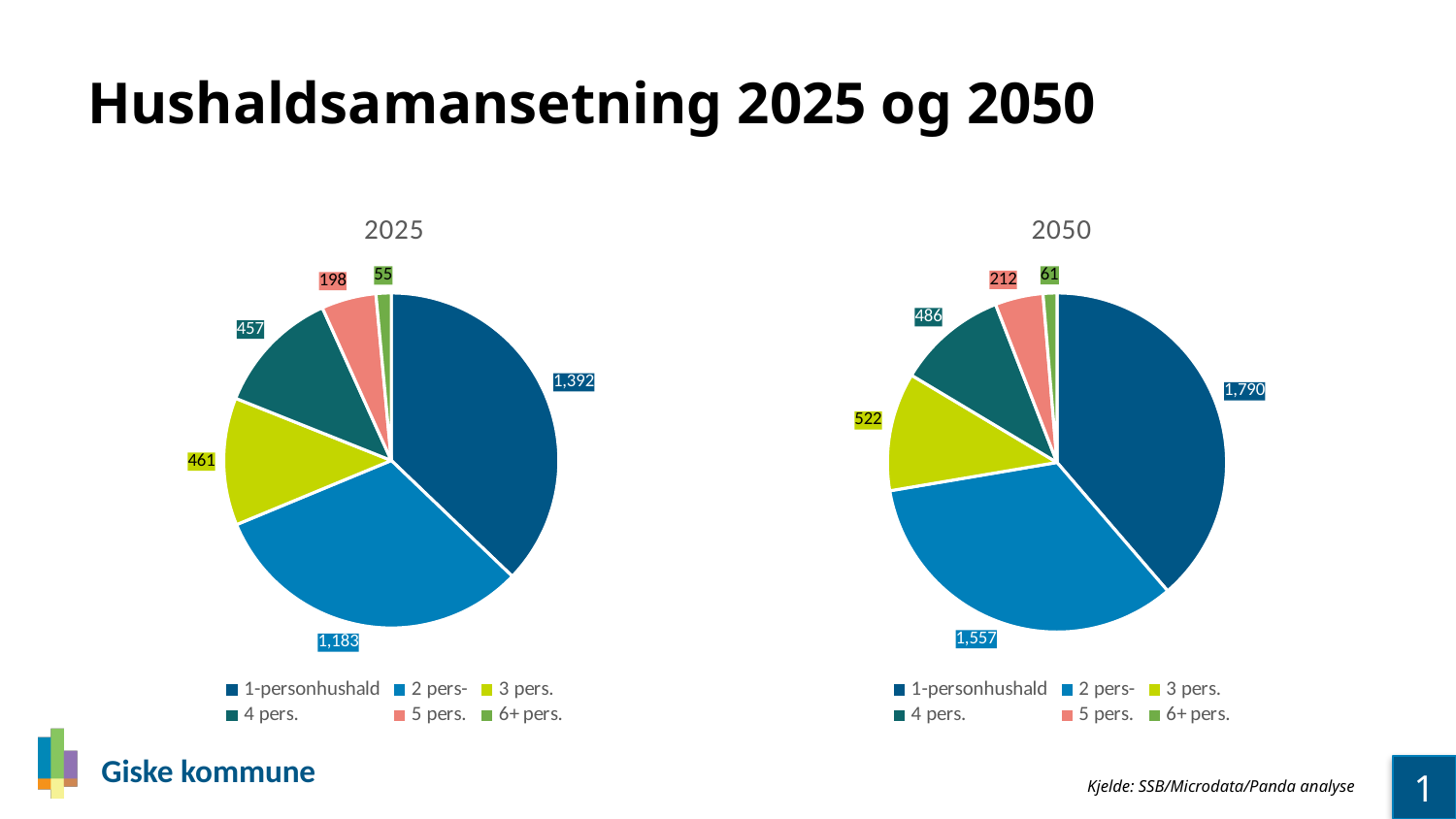
In the 2025 pie chart, what is the value for 1-personhushald? 1,392 In the 2050 pie chart, what is the value for 2 pers-? 1,557 In the 2050 pie chart, which category has the smallest slice? 6+ pers. In the 2050 pie chart, what is the value for 3 pers.? 522 In the 2025 pie chart, which category has the largest slice? 1-personhushald Which is larger: the 4 pers. value in the 2050 chart or the 4 pers. value in the 2025 chart? 2050 chart (486) What is the difference between the 1-personhushald value in the 2050 chart and in the 2025 chart? 398 How many categories does the 2025 pie chart show? 6 What is the title of the left chart? 2025 What type of chart is used for the 2050 data? Pie chart In the 2025 pie chart, what is the difference between the 1-personhushald and 2 pers- values? 209 In the 2025 pie chart, what is the value for 5 pers.? 198